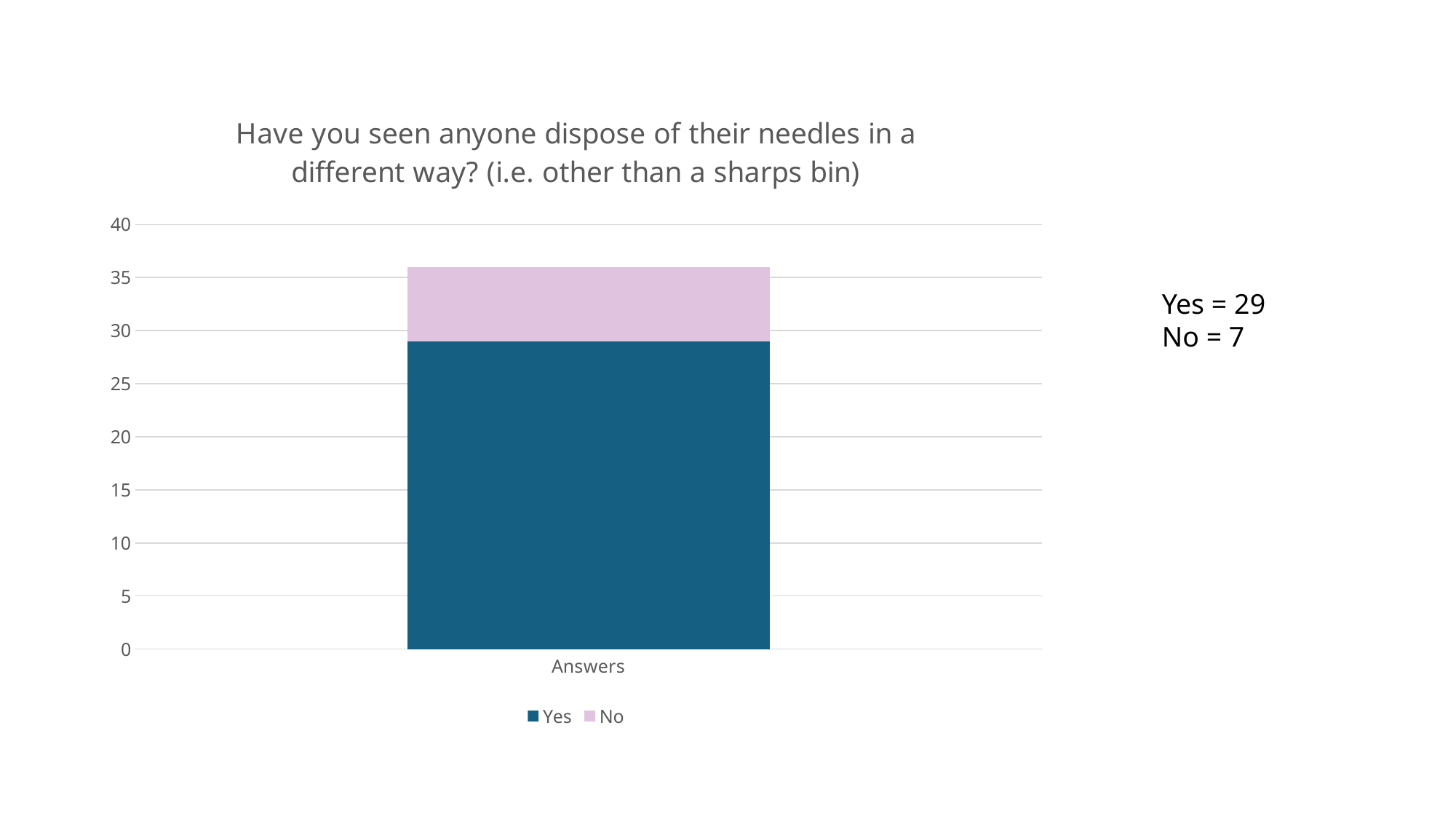
What is the label of the category on the x axis? Answers What is the total height of the stacked bar for Answers? 36 Which series has the larger value, Yes or No? Yes What is the difference between the Yes and No values? 22 How many categories are shown on the x axis? 1 What kind of chart is shown on the slide? bar chart What is the value for Yes? 29 Is the total of the stacked bar greater or less than 30? greater What is the value for No? 7 Which series is shown in the lighter pink colour? No How many series does the legend list? 2 Which series has the smallest value? No